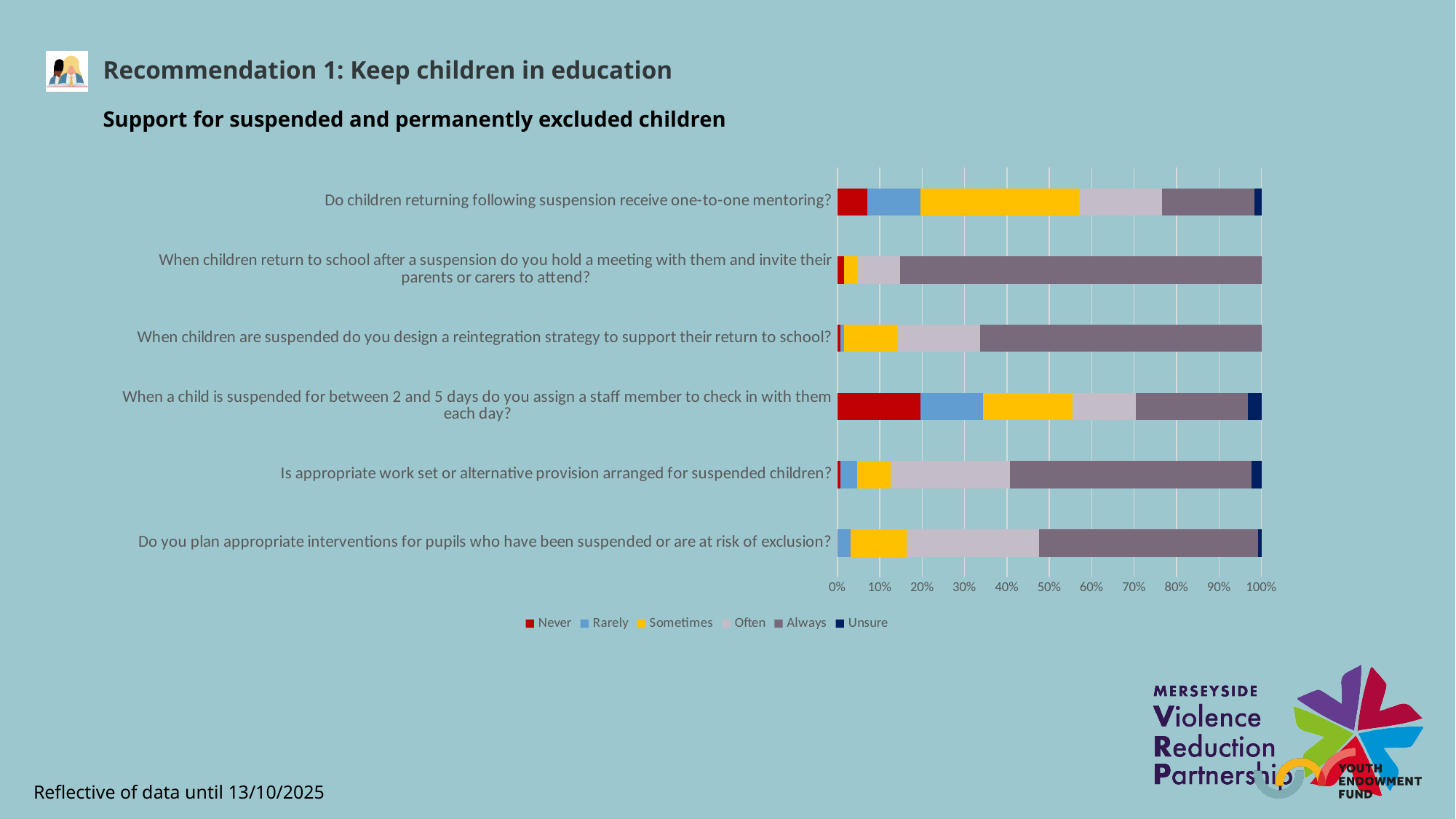
How many questions (categories) are plotted on the chart? 6 How many series does the chart's legend list? 6 Which question has the largest 'Never' share? When a child is suspended for between 2 and 5 days do you assign a staff member to check in with them each day? Is the 'Sometimes' share for 'Do children returning following suspension receive one-to-one mentoring?' greater or less than 30%? greater What kind of chart is shown on the slide? Stacked bar chart What is the title of the chart? Support for suspended and permanently excluded children Which response option is listed first in the chart's legend? Never Which has the larger 'Always' share: 'When children are suspended do you design a reintegration strategy to support their return to school?' or 'Is appropriate work set or alternative provision arranged for suspended children?'? When children are suspended do you design a reintegration strategy to support their return to school? Which question has the largest 'Always' share? When children return to school after a suspension do you hold a meeting with them and invite their parents or carers to attend? Is the 'Always' share for 'When children return to school after a suspension do you hold a meeting with them and invite their parents or carers to attend?' greater or less than 80%? greater Is the 'Never' share for 'When a child is suspended for between 2 and 5 days do you assign a staff member to check in with them each day?' greater or less than 10%? greater Which has the larger 'Never' share: 'Do children returning following suspension receive one-to-one mentoring?' or 'When a child is suspended for between 2 and 5 days do you assign a staff member to check in with them each day?'? When a child is suspended for between 2 and 5 days do you assign a staff member to check in with them each day?